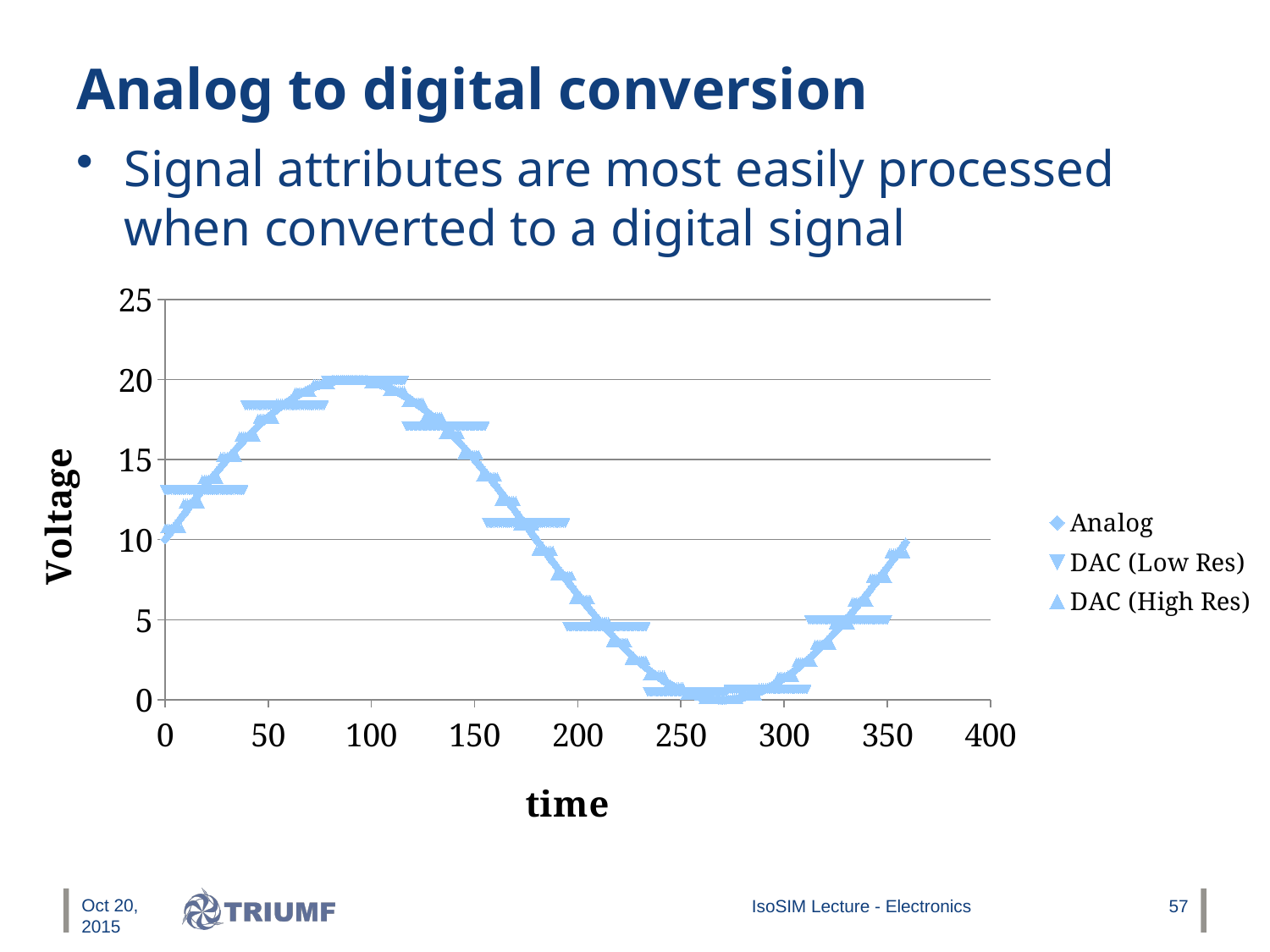
Do the values of the Analog series rise or fall between time 0 and time 90? rise What is the title of the vertical axis of the chart? Voltage Is the value of the Analog series at time 240 greater or less than 5? less What is the title of the horizontal axis of the chart? time Is the value of the Analog series at time 120 greater or less than 15? greater What kind of chart is shown on the slide? scatter chart Is the peak value of the Analog series greater or less than 15? greater How many series does the chart legend list? 3 Do the values of the Analog series rise or fall between time 100 and time 250? fall